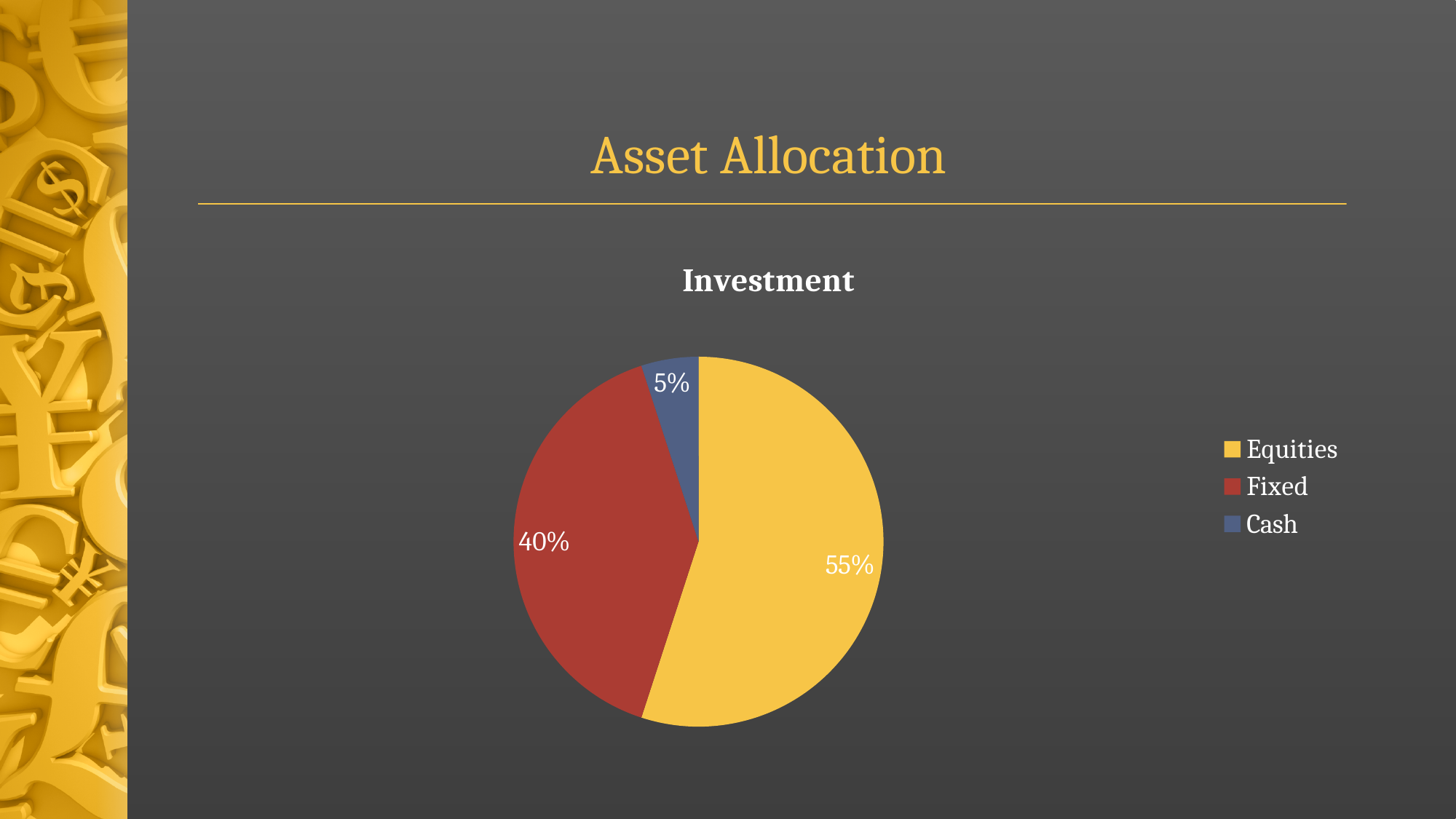
What is the difference in percentage points between the Equities and Fixed slices? 15% What share of the pie does Cash hold? 5% What share of the pie does Fixed hold? 40% Which category has the smallest slice of the pie? Cash Which is larger, the Fixed slice or the Cash slice? Fixed What share of the pie does Equities hold? 55% What colour is the Cash slice in the pie chart? Blue How many categories are shown in the pie chart? 3 Which category has the largest slice of the pie? Equities What kind of chart is shown on the slide? Pie chart What is the title of the chart? Investment What is the difference in percentage points between the Fixed and Cash slices? 35%